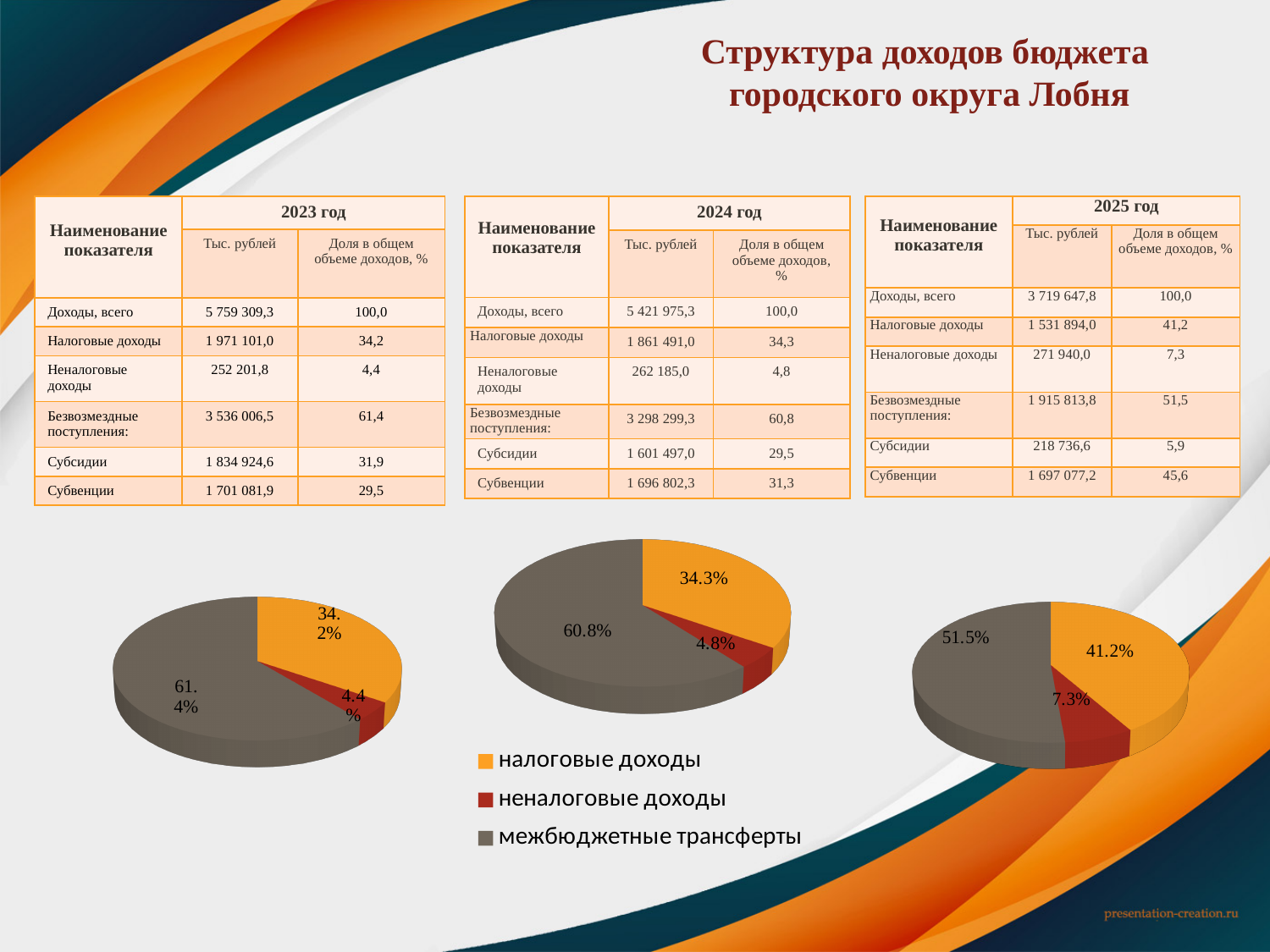
In the middle pie chart, which category has the smallest slice? неналоговые доходы In the middle pie chart, what share is labelled for the grey slice (межбюджетные трансферты)? 60.8% In the right pie chart, which category has the largest slice? межбюджетные трансферты How many slices does each pie chart on the slide have? 3 In the right pie chart, what is the difference between the grey slice (51.5%) and the orange slice (41.2%)? 10.3% Which is larger: the red slice in the right pie chart or the red slice in the left pie chart? the right pie chart (7.3%) In the right pie chart, what share is labelled for the orange slice (налоговые доходы)? 41.2% What type of chart is used for the three charts at the bottom of the slide? pie chart In the middle pie chart, what share is labelled for the red slice (неналоговые доходы)? 4.8% In the left pie chart, what share is labelled for the orange slice (налоговые доходы)? 34.2% How many entries does the shared legend below the pie charts list? 3 In the left pie chart, what share is labelled for the grey slice (межбюджетные трансферты)? 61.4%